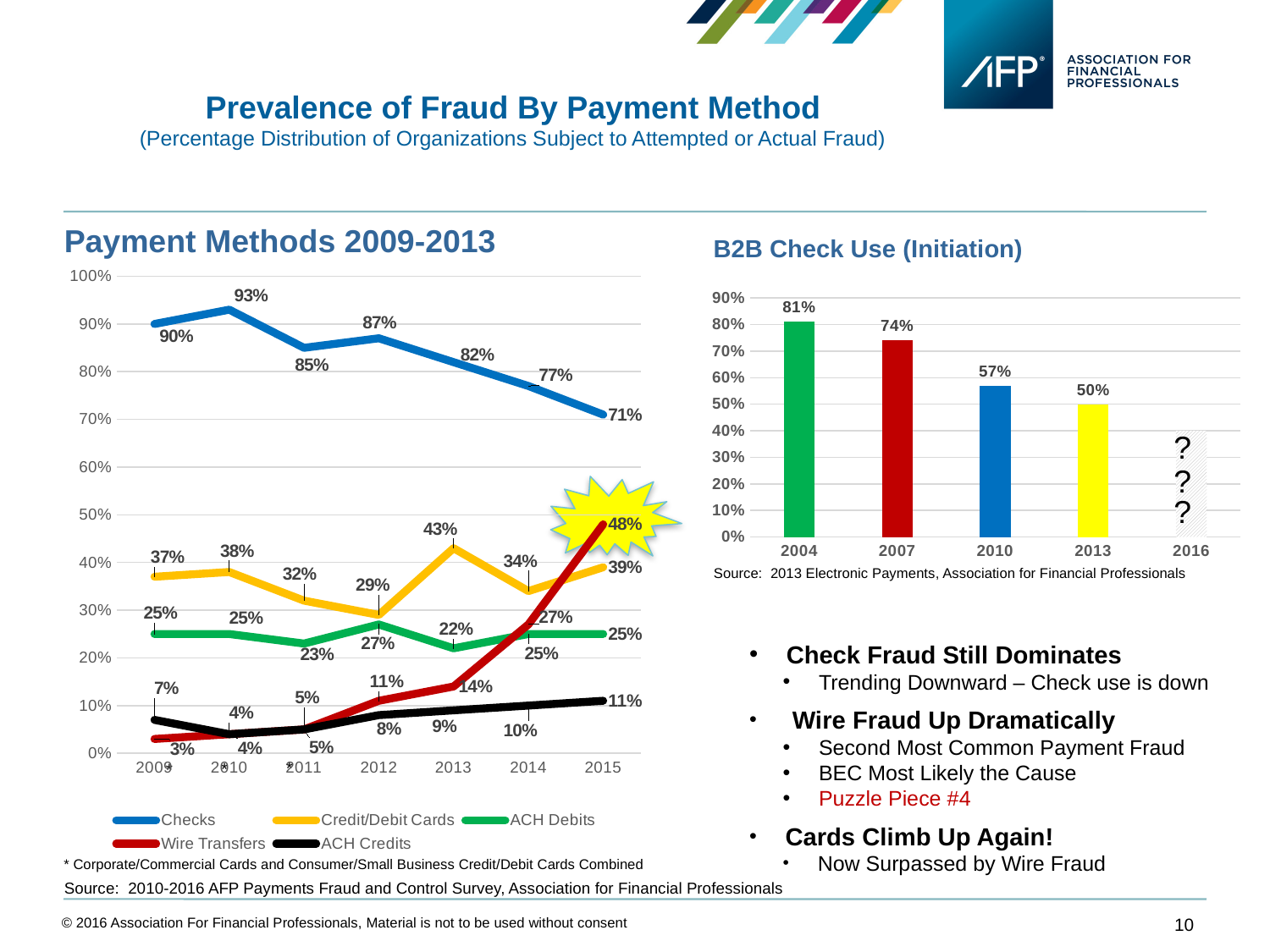
In the 'Payment Methods 2009-2013' chart, what is the difference between the Checks values in 2009 and 2015? 19% In the 'Payment Methods 2009-2013' chart, which is larger in 2015: Credit/Debit Cards or Wire Transfers? Wire Transfers In the 'B2B Check Use (Initiation)' chart, how many years are shown on the x axis? 5 In the 'Payment Methods 2009-2013' chart, in which year is the Checks value highest? 2010 In the 'B2B Check Use (Initiation)' chart, what is the value for 2010? 57% In the 'Payment Methods 2009-2013' chart, how many series does the legend list? 5 In the 'B2B Check Use (Initiation)' chart, what is the difference between the 2004 and 2013 values? 31% In the 'Payment Methods 2009-2013' chart, does the Checks line rise or fall from 2010 to 2015? Fall What kind of chart is 'B2B Check Use (Initiation)'? Bar chart In the 'B2B Check Use (Initiation)' chart, which year has the highest labeled value? 2004 In the 'Payment Methods 2009-2013' chart, what is the value for Checks in 2015? 71% In the 'Payment Methods 2009-2013' chart, what is the value for Wire Transfers in 2015? 48%